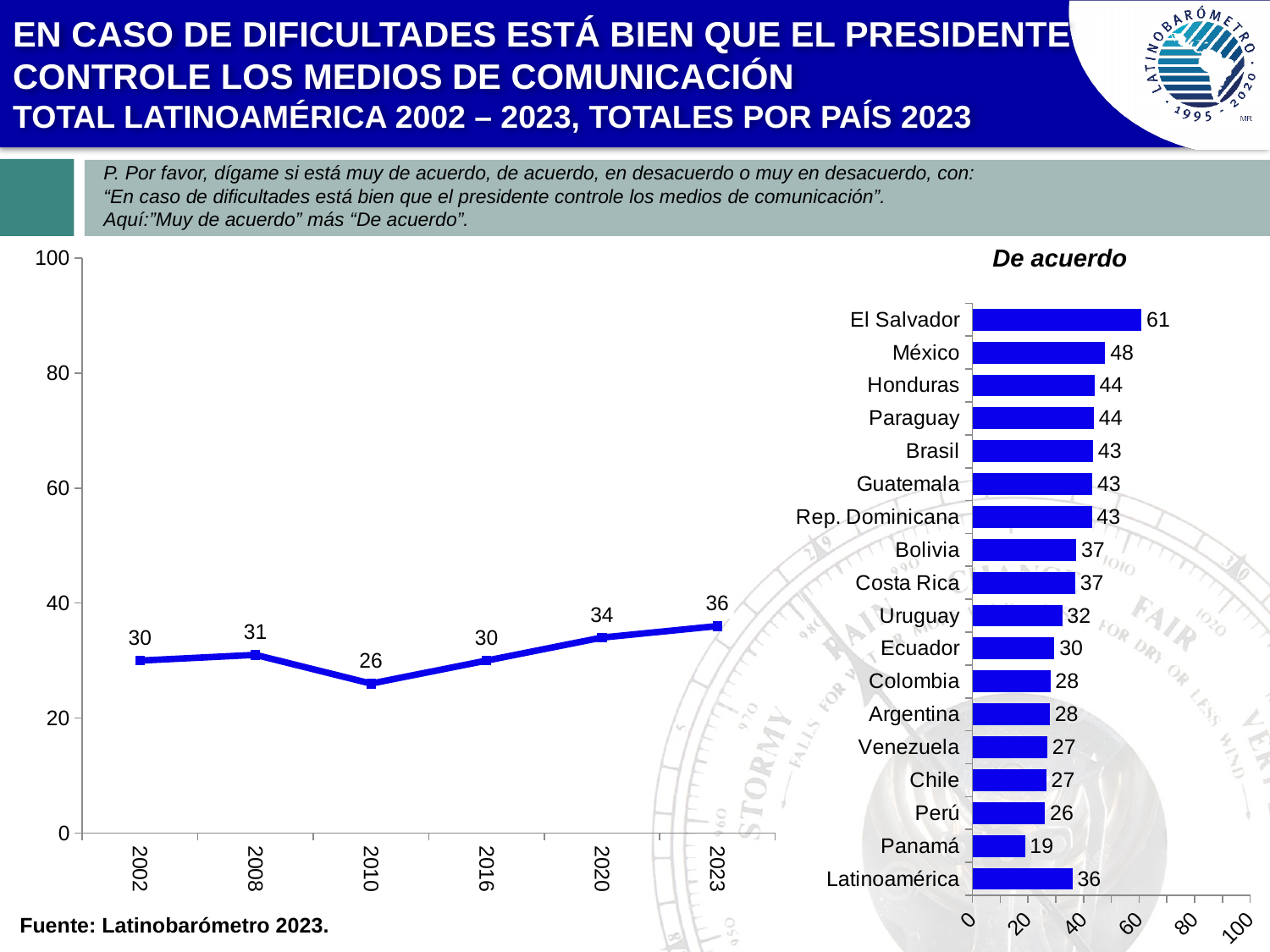
In the line chart on the left, what is the value for 2023? 36 In the line chart on the left, which year has the lowest value? 2010 In the bar chart titled 'De acuerdo', what is the value for México? 48 In the line chart on the left, do the values rise or fall between 2010 and 2023? rise In the bar chart titled 'De acuerdo', which is larger, the value for Bolivia or the value for Ecuador? Bolivia In the bar chart titled 'De acuerdo', which country has the lowest value? Panamá What kind of chart is the chart titled 'De acuerdo'? bar chart In the bar chart titled 'De acuerdo', which country has the highest value? El Salvador In the line chart on the left, how many data points are plotted? 6 In the line chart on the left, what is the difference between the 2023 value and the 2002 value? 6 In the bar chart titled 'De acuerdo', what is the difference between El Salvador and Panamá? 42 In the line chart on the left, what is the value for 2010? 26